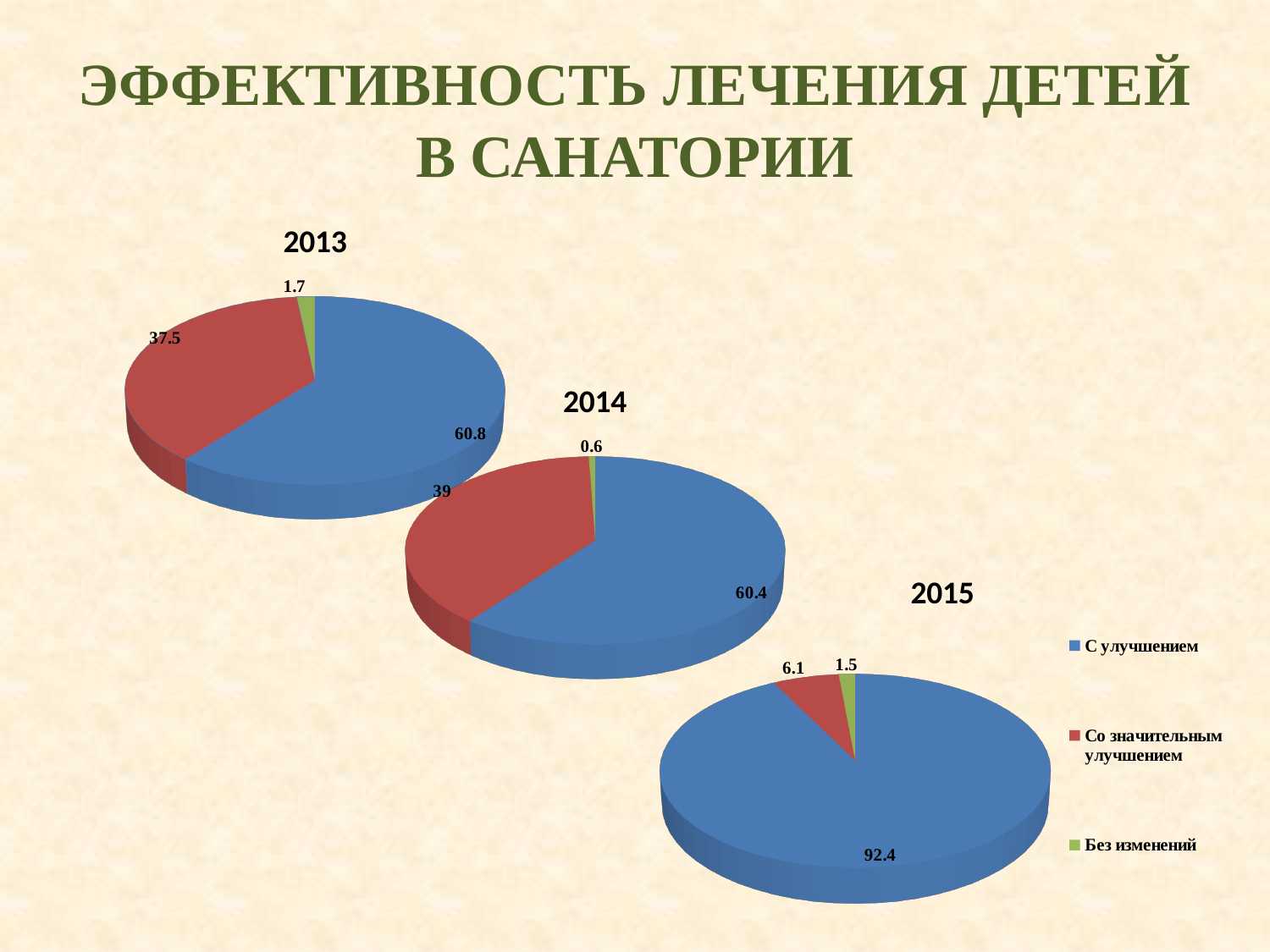
How many categories does the legend list? 3 Which is larger: 'Со значительным улучшением' in 2013 or in 2014? 2014 In the 2013 pie chart, what is the value for 'С улучшением'? 60.8 What is the difference between the 'С улучшением' values in the 2015 and 2013 pie charts? 31.6 In the 2013 pie chart, what is the value for 'Со значительным улучшением'? 37.5 In the 2015 pie chart, what is the value for 'Со значительным улучшением'? 6.1 In the 2014 pie chart, what is the value for 'Без изменений'? 0.6 What type of chart is used for the 2013 data? pie chart In the 2015 pie chart, what is the value for 'С улучшением'? 92.4 In the 2014 pie chart, what is the value for 'Со значительным улучшением'? 39 In the 2015 pie chart, which category has the largest slice? С улучшением In the 2013 pie chart, which category has the smallest slice? Без изменений